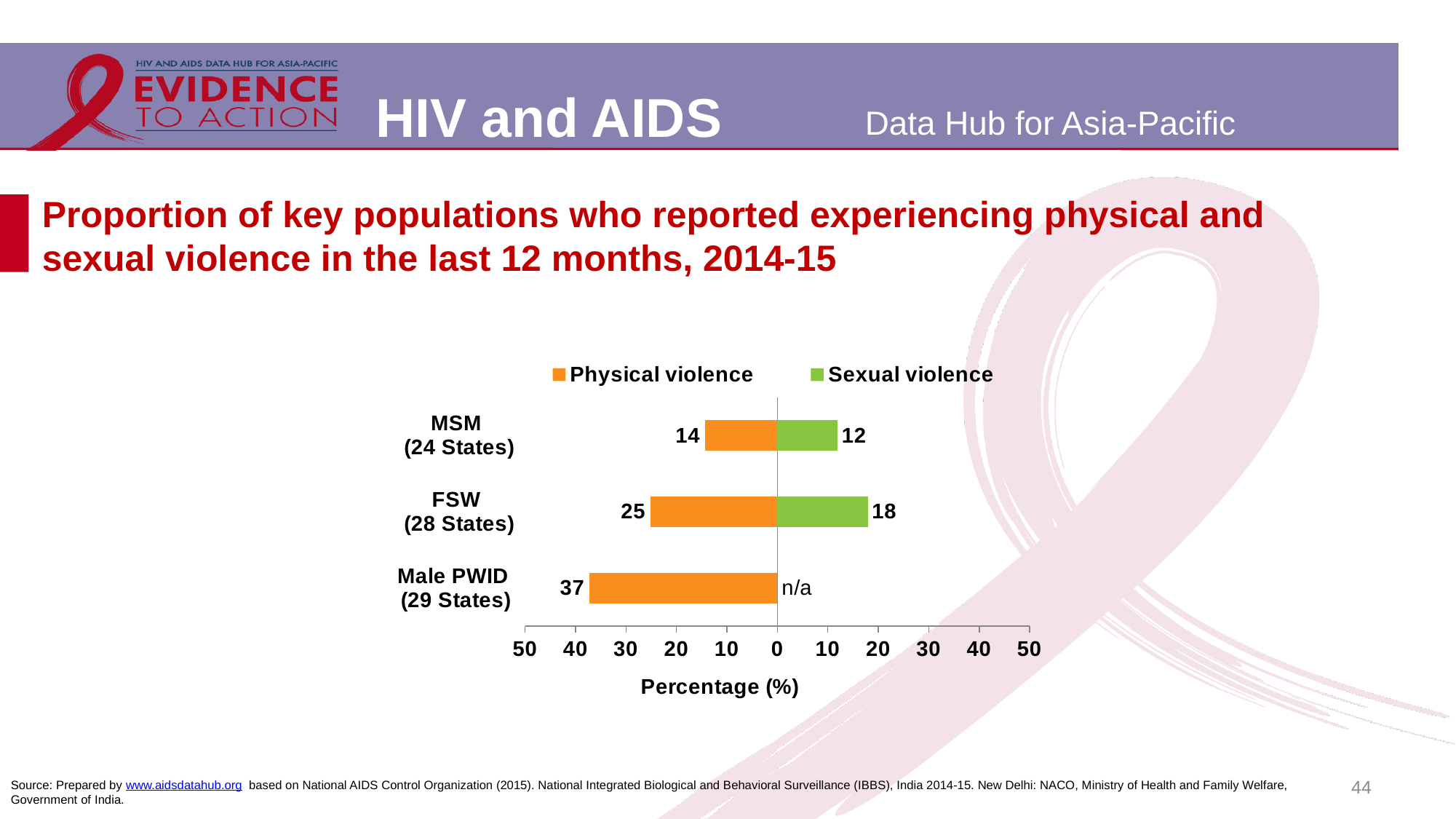
What kind of chart is shown on the slide? Bar chart What percentage of MSM (24 States) reported experiencing physical violence? 14 Which key population has the lowest reported physical violence? MSM (24 States) What is the label of the horizontal axis? Percentage (%) Which is larger for FSW (28 States): physical violence or sexual violence? Physical violence How many key populations are shown on the chart? 3 What percentage of FSW (28 States) reported experiencing sexual violence? 18 How many series does the legend list? 2 What is the difference between physical violence for Male PWID (29 States) and FSW (28 States)? 12 What value is shown for sexual violence among Male PWID (29 States)? n/a Which key population has the highest reported physical violence? Male PWID (29 States) What percentage of Male PWID (29 States) reported experiencing physical violence? 37